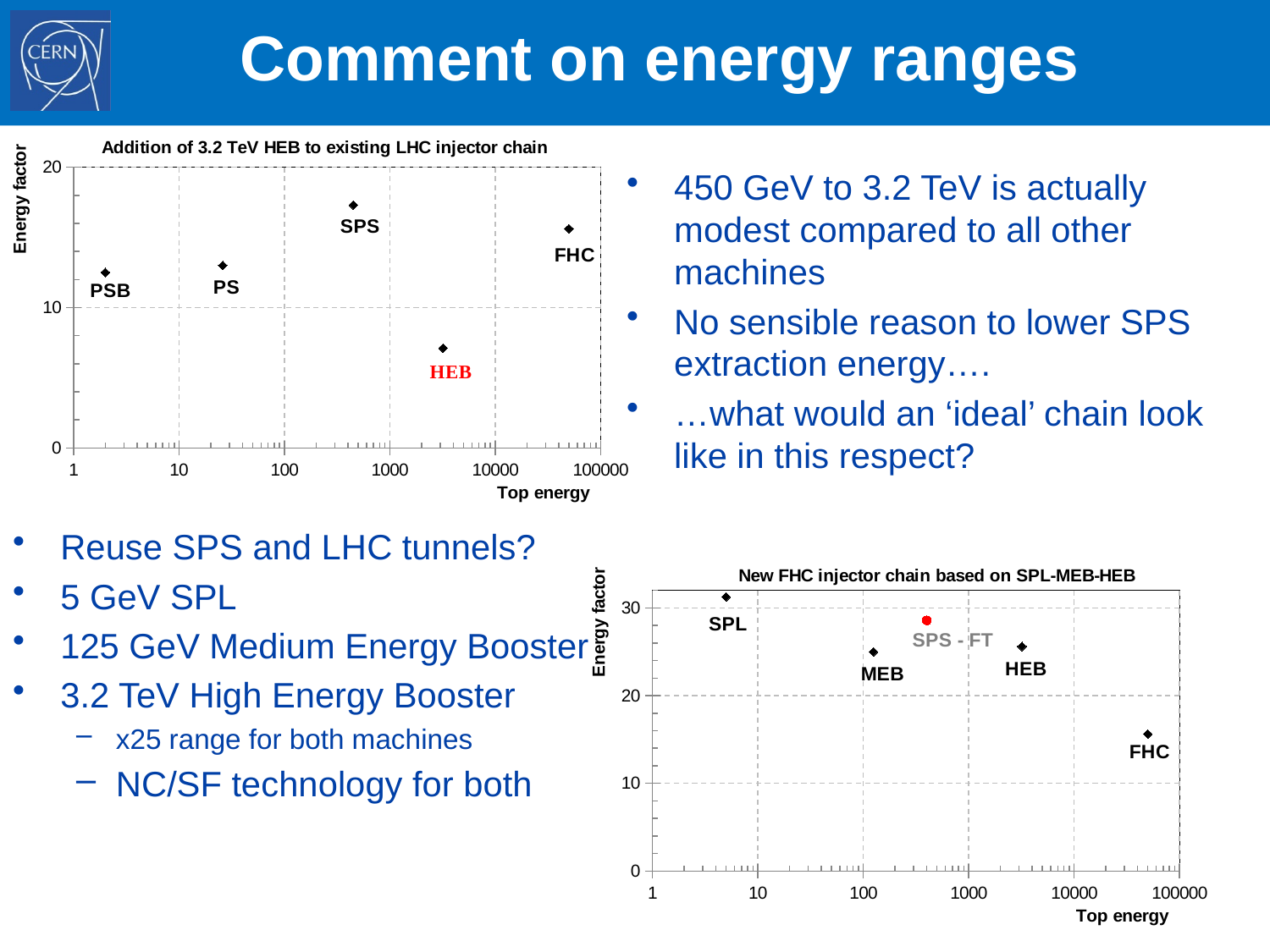
In the bottom-right chart 'New FHC injector chain based on SPL-MEB-HEB', which has the larger energy factor, SPS - FT or MEB? SPS - FT In the bottom-right chart 'New FHC injector chain based on SPL-MEB-HEB', which machine has the lowest energy factor? FHC In the top-left chart 'Addition of 3.2 TeV HEB to existing LHC injector chain', which machine has the lowest energy factor? HEB What is the label of the x axis on the bottom-right chart 'New FHC injector chain based on SPL-MEB-HEB'? Top energy In the top-left chart 'Addition of 3.2 TeV HEB to existing LHC injector chain', is the energy factor for HEB greater or less than 10? less In the bottom-right chart 'New FHC injector chain based on SPL-MEB-HEB', which machine has the highest energy factor? SPL In the bottom-right chart 'New FHC injector chain based on SPL-MEB-HEB', is the energy factor for FHC greater or less than 20? less What kind of chart is the top-left chart titled 'Addition of 3.2 TeV HEB to existing LHC injector chain'? Scatter chart In the top-left chart 'Addition of 3.2 TeV HEB to existing LHC injector chain', how many labelled data points are plotted? 5 In the top-left chart 'Addition of 3.2 TeV HEB to existing LHC injector chain', which machine has the highest energy factor? SPS In the bottom-right chart 'New FHC injector chain based on SPL-MEB-HEB', how many labelled data points are plotted? 5 In the top-left chart 'Addition of 3.2 TeV HEB to existing LHC injector chain', which has the larger energy factor, SPS or FHC? SPS